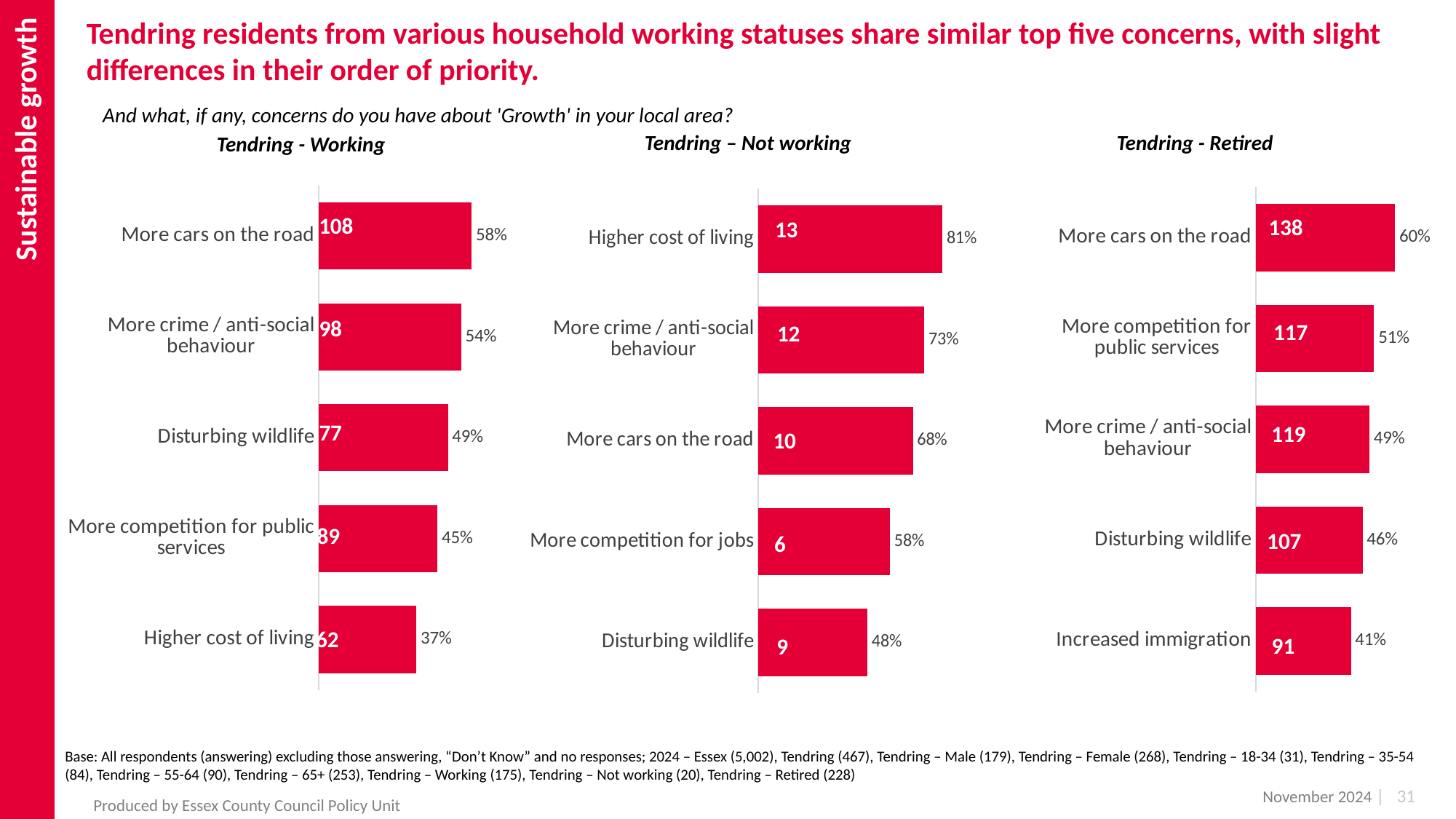
In the 'Tendring - Retired' chart, which concern has the highest percentage? More cars on the road What is the survey question shown above the three charts? And what, if any, concerns do you have about 'Growth' in your local area? In the 'Tendring - Working' chart, what is the difference in percentage points between 'More cars on the road' and 'Higher cost of living'? 21 In the 'Tendring – Not working' chart, which concern has the lowest percentage? Disturbing wildlife How many concerns are listed in the 'Tendring – Not working' chart? 5 In the 'Tendring - Retired' chart, which has the larger percentage: 'Disturbing wildlife' or 'Increased immigration'? Disturbing wildlife In the 'Tendring – Not working' chart, what count is shown inside the bar for 'More competition for jobs'? 6 In the 'Tendring – Not working' chart, what percentage is shown for 'Higher cost of living'? 81% In the 'Tendring - Working' chart, what percentage is shown for 'More cars on the road'? 58% In the 'Tendring - Working' chart, what count is shown inside the bar for 'Higher cost of living'? 62 What type of chart is used for 'Tendring - Working'? Bar chart In the 'Tendring - Retired' chart, what count is shown inside the bar for 'More competition for public services'? 117